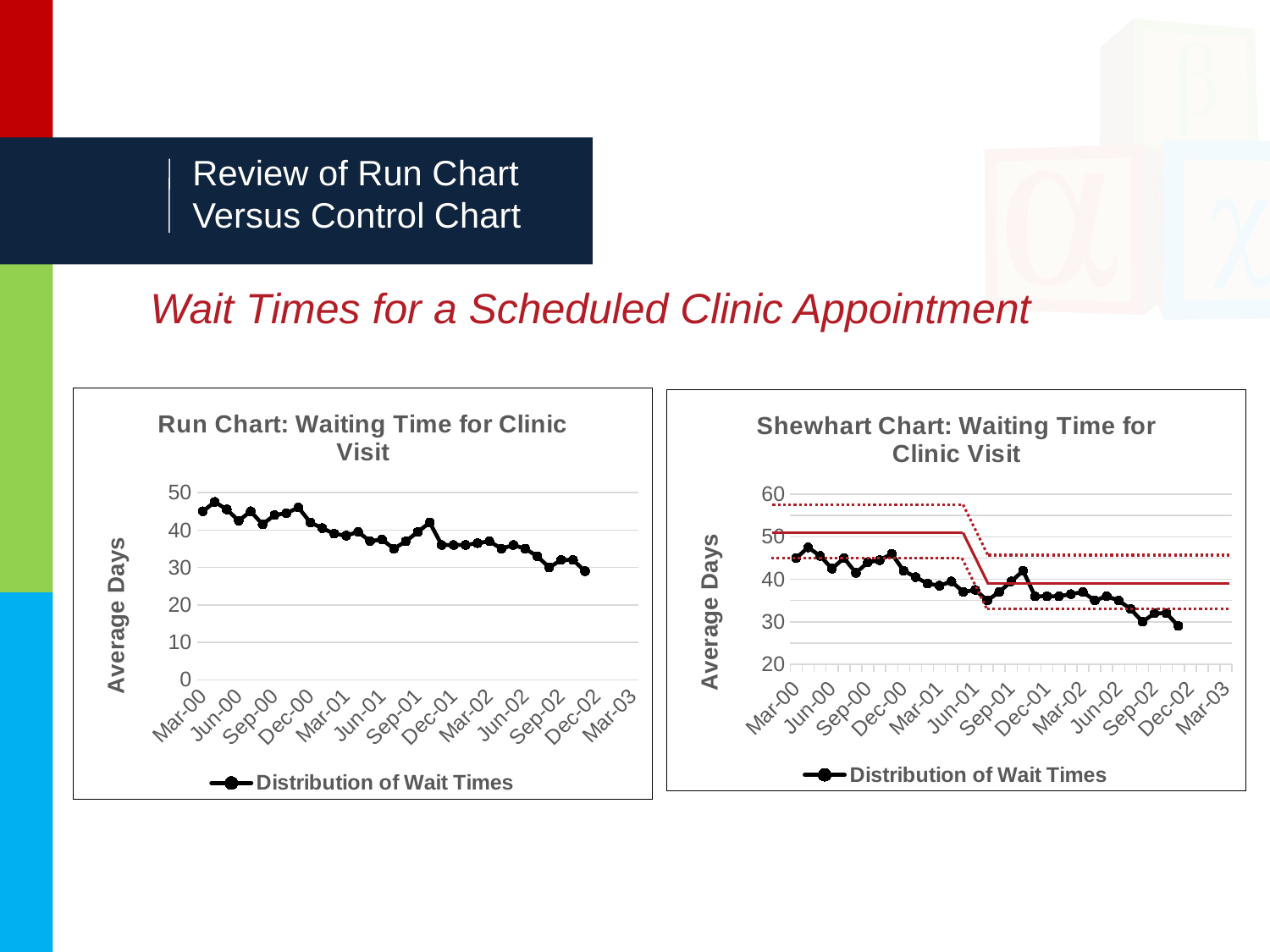
How many series does the legend of the Run Chart: Waiting Time for Clinic Visit list? 1 In the Shewhart Chart: Waiting Time for Clinic Visit, is the value for Dec-00 greater or less than 40? greater What is the y-axis label of the Shewhart Chart: Waiting Time for Clinic Visit? Average Days In the Run Chart: Waiting Time for Clinic Visit, is the value for Mar-00 greater or less than 40? greater What kind of chart is the Run Chart: Waiting Time for Clinic Visit? line chart In the Shewhart Chart: Waiting Time for Clinic Visit, do the values generally rise or fall along the x axis? fall How many date labels are shown on the x axis of the Shewhart Chart: Waiting Time for Clinic Visit? 13 What kind of chart is the Shewhart Chart: Waiting Time for Clinic Visit? line chart In the Run Chart: Waiting Time for Clinic Visit, do the values generally rise or fall from Mar-00 to Dec-02? fall In the Shewhart Chart: Waiting Time for Clinic Visit, is the value for Jun-01 greater or less than 40? less